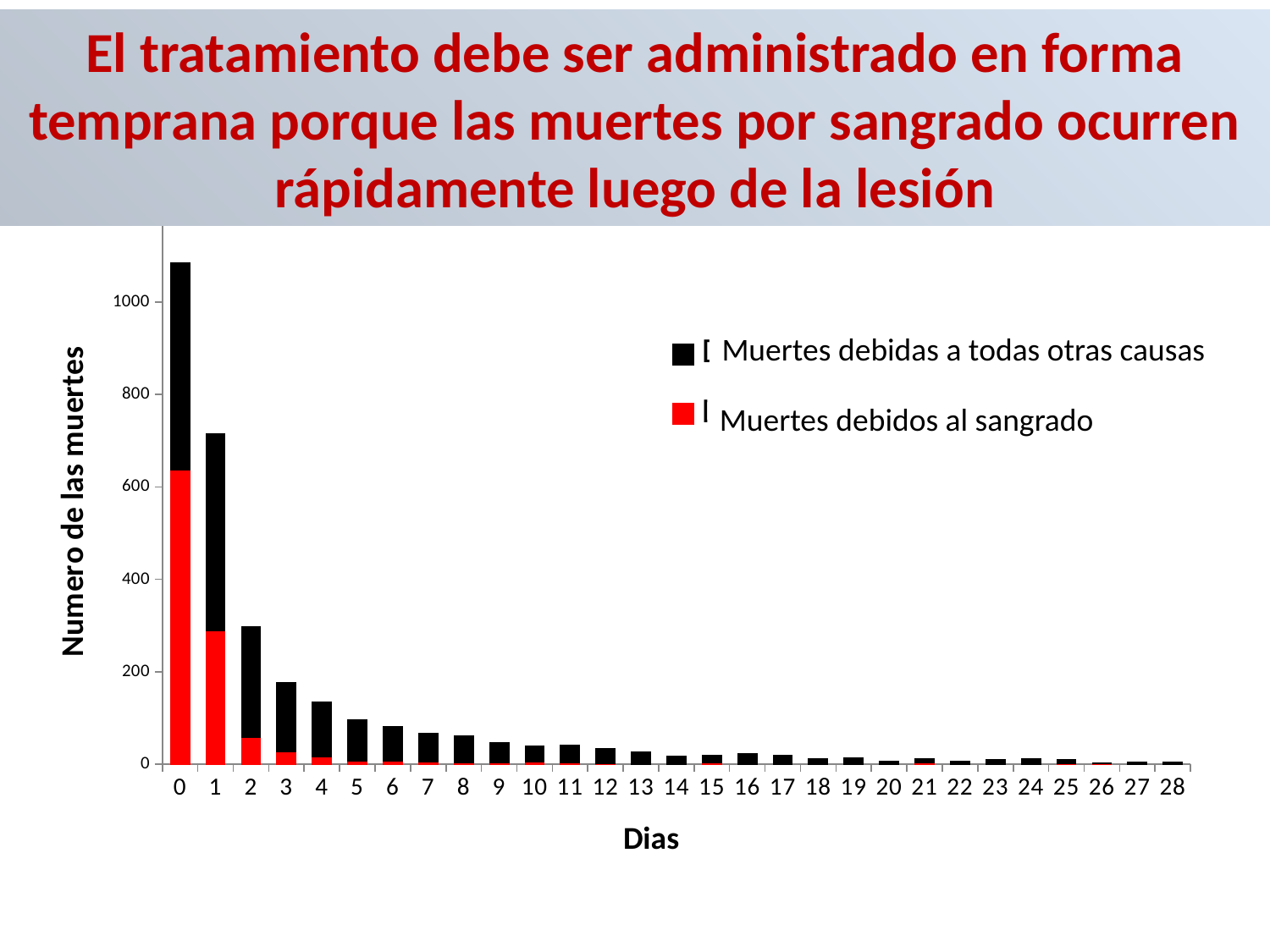
Is the value for 'Muertes debidos al sangrado' on day 1 greater or less than 400? less Do the total deaths rise or fall as the days increase along the x axis? fall How many series does the legend list? 2 Which colour represents 'Muertes debidos al sangrado' in the legend? red What is the title of the x axis? Dias Is the value for 'Muertes debidos al sangrado' on day 0 greater or less than 400? greater Is the total value of the bar for day 0 greater or less than 1000? greater Which day has the highest total number of deaths? 0 How many days (categories) are shown on the x axis? 29 Which has a larger total number of deaths, day 2 or day 3? day 2 What kind of chart is shown on the slide? bar chart